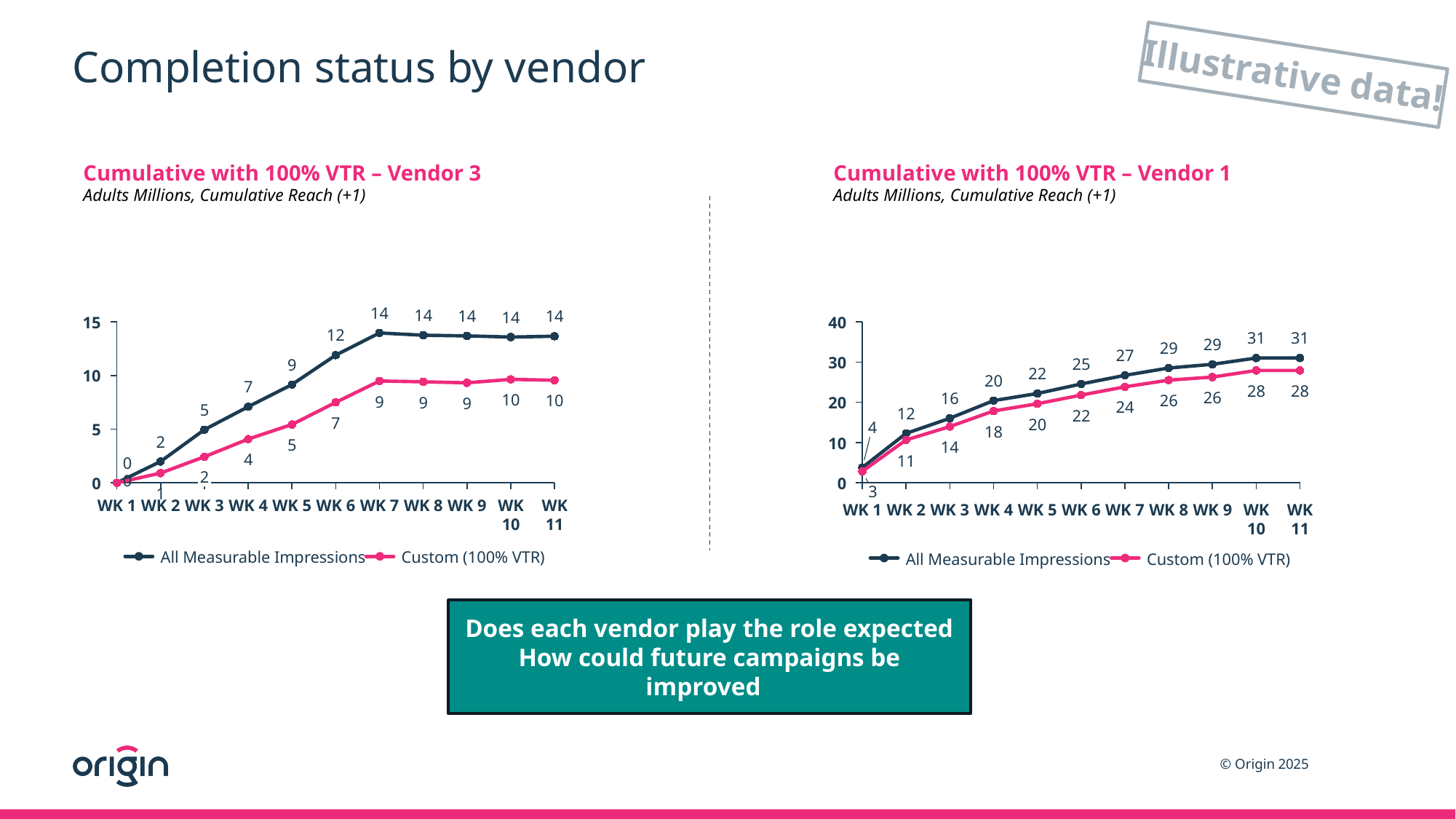
In the Vendor 1 chart, which series has the higher value at WK 2? All Measurable Impressions In the Vendor 1 chart, what is the difference between All Measurable Impressions and Custom (100% VTR) at WK 11? 3 In the Vendor 3 chart, what is the value of All Measurable Impressions at WK 6? 12 In the Vendor 1 chart, what is the value of Custom (100% VTR) at WK 7? 24 In the Vendor 1 chart, what is the value of All Measurable Impressions at WK 4? 20 In the Vendor 3 chart, at which week does All Measurable Impressions first reach its highest value of 14? WK 7 How many series does the legend of the Vendor 3 chart list? 2 How many weeks are shown on the x axis of the Vendor 1 chart? 11 What kind of chart is the Vendor 1 chart? Line chart In the Vendor 1 chart, does the Custom (100% VTR) series generally rise or fall from WK 1 to WK 11? Rise In the Vendor 3 chart, what is the value of Custom (100% VTR) at WK 11? 10 In the Vendor 3 chart, what is the difference between All Measurable Impressions and Custom (100% VTR) at WK 7? 5